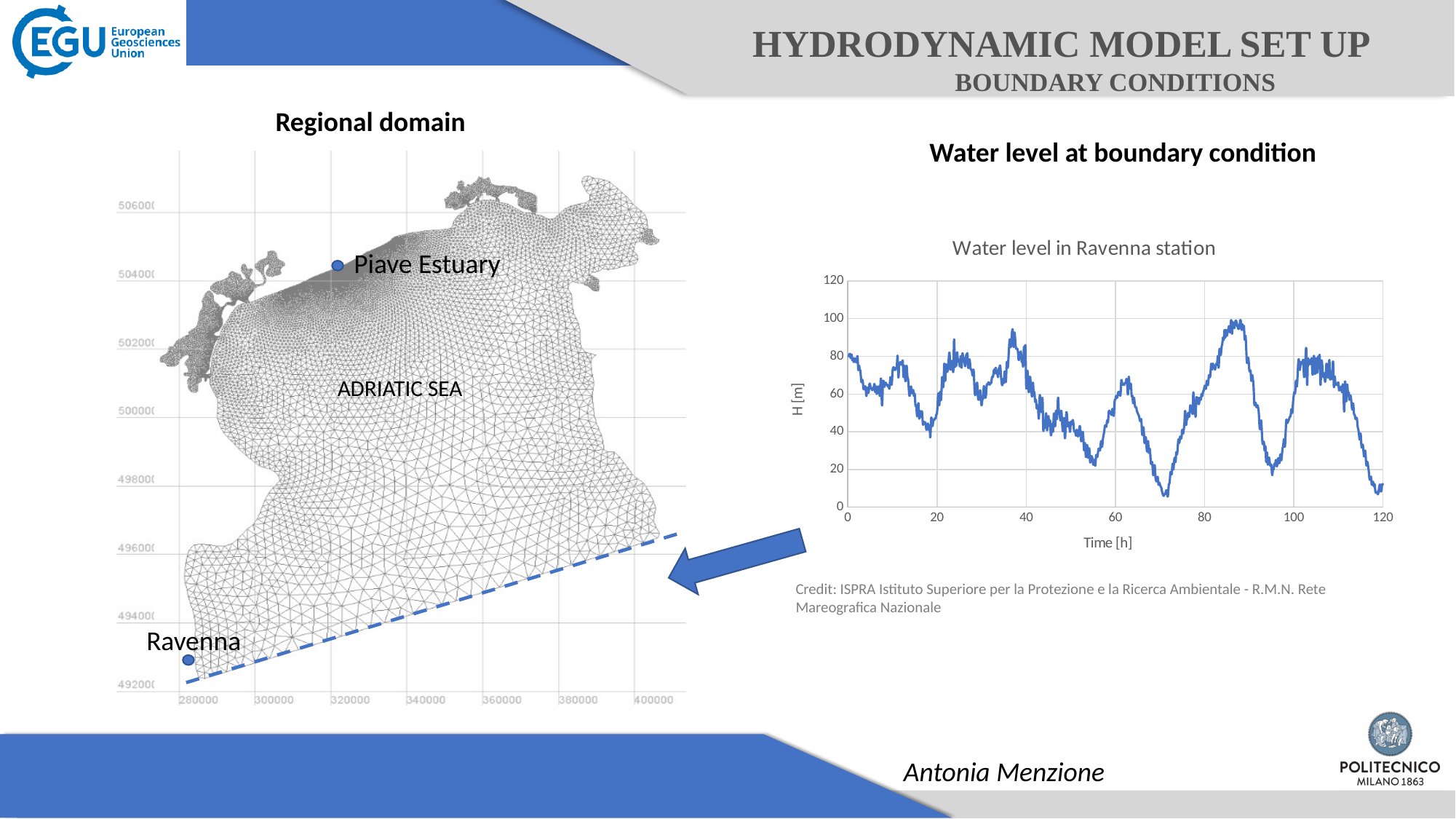
What is the label of the x axis of the 'Water level in Ravenna station' chart? Time [h] In the 'Water level in Ravenna station' chart, is the water level at about 87 h greater or less than 80? greater What is the maximum value shown on the x axis of the 'Water level in Ravenna station' chart? 120 In the 'Water level in Ravenna station' chart, does the water level rise or fall between about 87 h and about 95 h? fall In the 'Water level in Ravenna station' chart, is the water level at about 55 h greater or less than 40? less In the 'Water level in Ravenna station' chart, is the water level at about 37 h greater or less than 80? greater What kind of chart is 'Water level in Ravenna station'? line chart How many data series are plotted in the 'Water level in Ravenna station' chart? 1 What is the title of the chart on the right side of the slide? Water level in Ravenna station In the 'Water level in Ravenna station' chart, is the water level higher at about 87 h or at about 70 h? at about 87 h